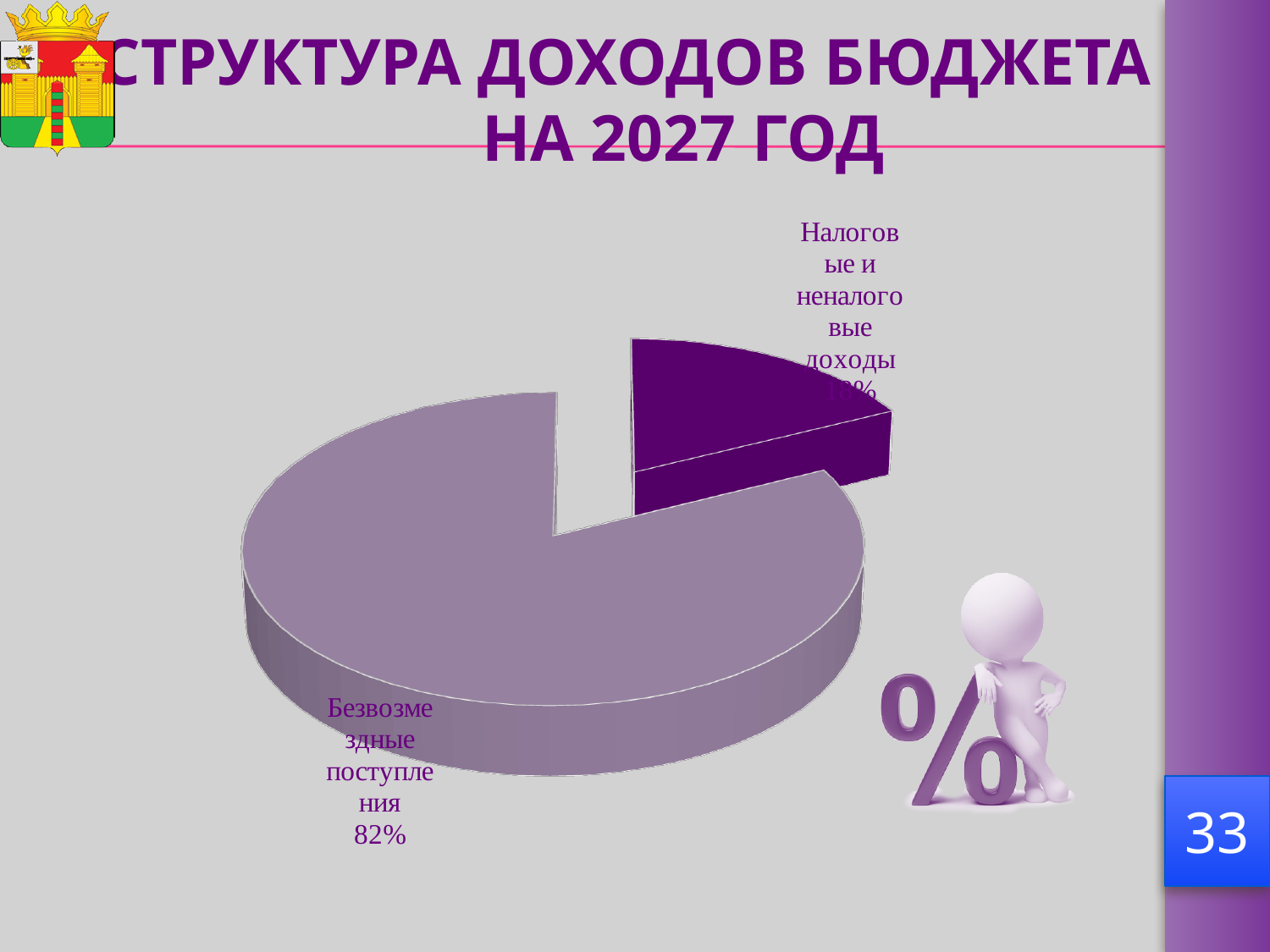
Which is larger: "Безвозмездные поступления" or "Налоговые и неналоговые доходы"? Безвозмездные поступления What is the value shown for "Безвозмездные поступления"? 82% Which category has the largest slice of the pie? Безвозмездные поступления What share of the pie does "Безвозмездные поступления" have? 82% Which category has the smallest slice of the pie? Налоговые и неналоговые доходы How many slices does the pie chart have? 2 What kind of chart is shown on the slide? pie chart What is the title of the slide containing the chart? СТРУКТУРА ДОХОДОВ БЮДЖЕТА НА 2027 ГОД Which year does the budget revenue structure chart refer to? 2027